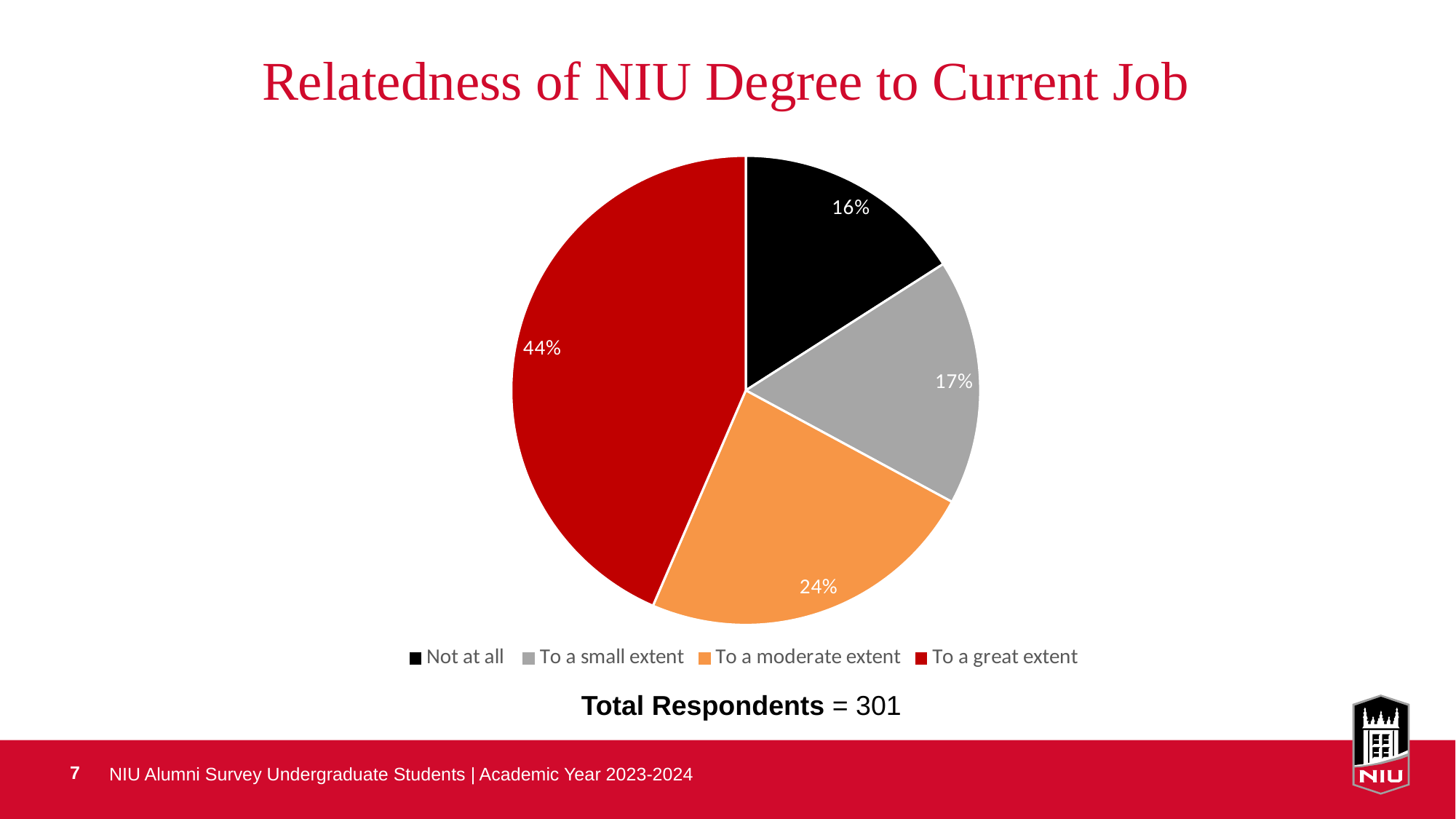
Which is larger: the share for "To a moderate extent" or the share for "To a small extent"? To a moderate extent What colour is the "To a moderate extent" slice? Orange What percentage of respondents answered "To a small extent"? 17% What kind of chart is shown on the slide? Pie chart What percentage of respondents answered "To a moderate extent"? 24% What percentage of respondents answered "Not at all"? 16% How many total respondents are reported on the slide? 301 What is the difference in percentage points between "To a great extent" and "To a moderate extent"? 20 What percentage of respondents answered "To a great extent"? 44% Which response category has the smallest share of the pie? Not at all How many categories does the pie chart show? 4 Which response category has the largest share of the pie? To a great extent